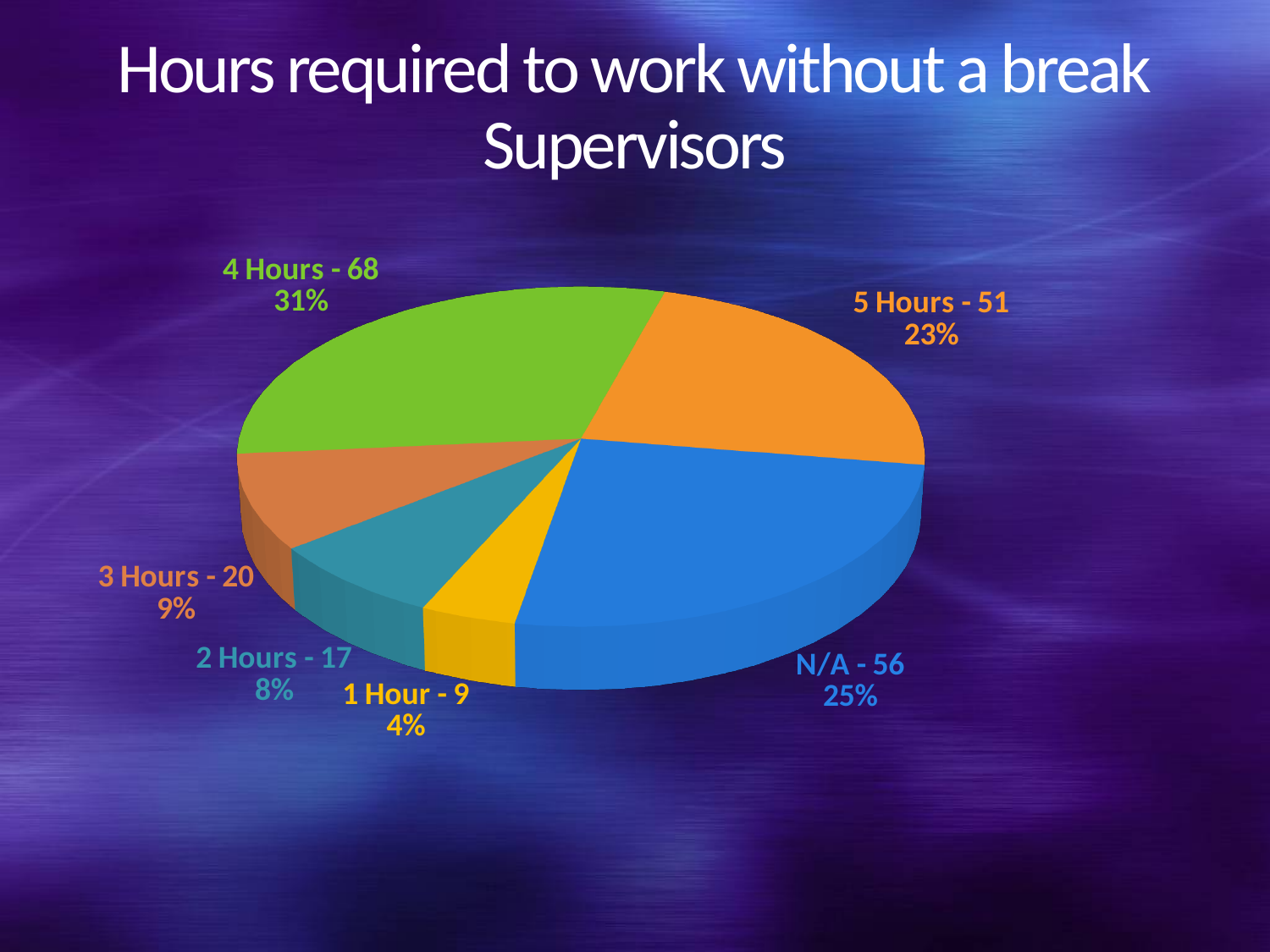
What is the difference between the counts for 4 Hours and 5 Hours? 17 What percentage share does the N/A slice have? 25% Which category has the largest slice? 4 Hours How many slices does the pie chart have? 6 Which is larger, the count for N/A or the count for 5 Hours? N/A What is the count for the 2 Hours slice? 17 What kind of chart is shown on the slide? Pie chart What colour is the 1 Hour slice? Yellow What is the title of the chart? Hours required to work without a break Supervisors What is the count for the 4 Hours slice? 68 Which category has the smallest slice? 1 Hour What percentage share does the 3 Hours slice have? 9%